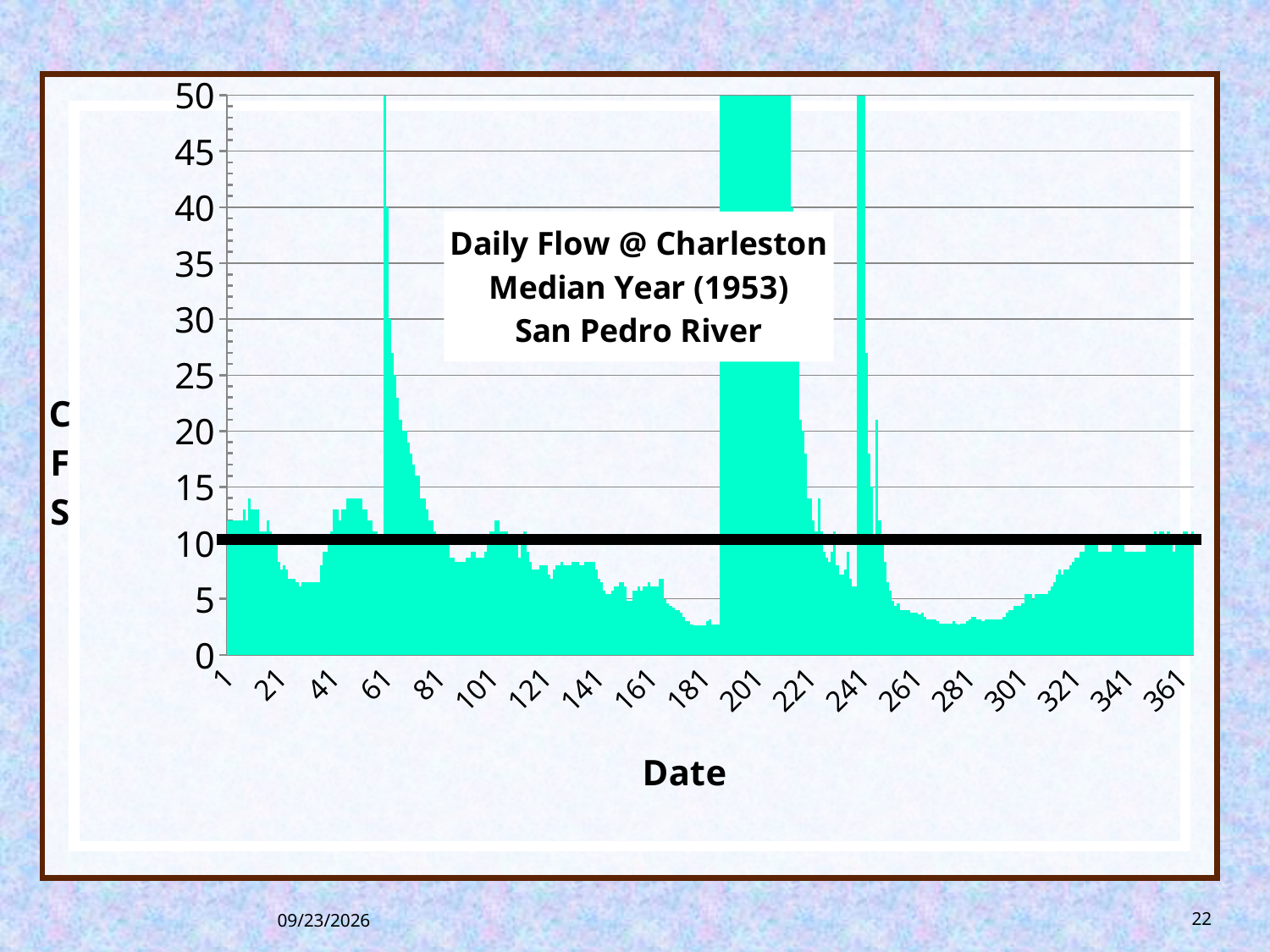
What kind of chart is shown on the slide? bar chart What label is shown on the vertical axis of the chart? CFS What is the title of the chart? Daily Flow @ Charleston Median Year (1953) San Pedro River Which has the larger flow value, day 201 or day 281? day 201 Between day 61 and day 101, do the flow values rise or fall? fall Is the flow value at day 261 greater or less than 10? less Is the flow value at day 201 greater or less than 40? greater Is the flow value at day 61 greater or less than 30? greater Which has the larger flow value, day 61 or day 161? day 61 Between day 261 and day 321, do the flow values rise or fall? rise